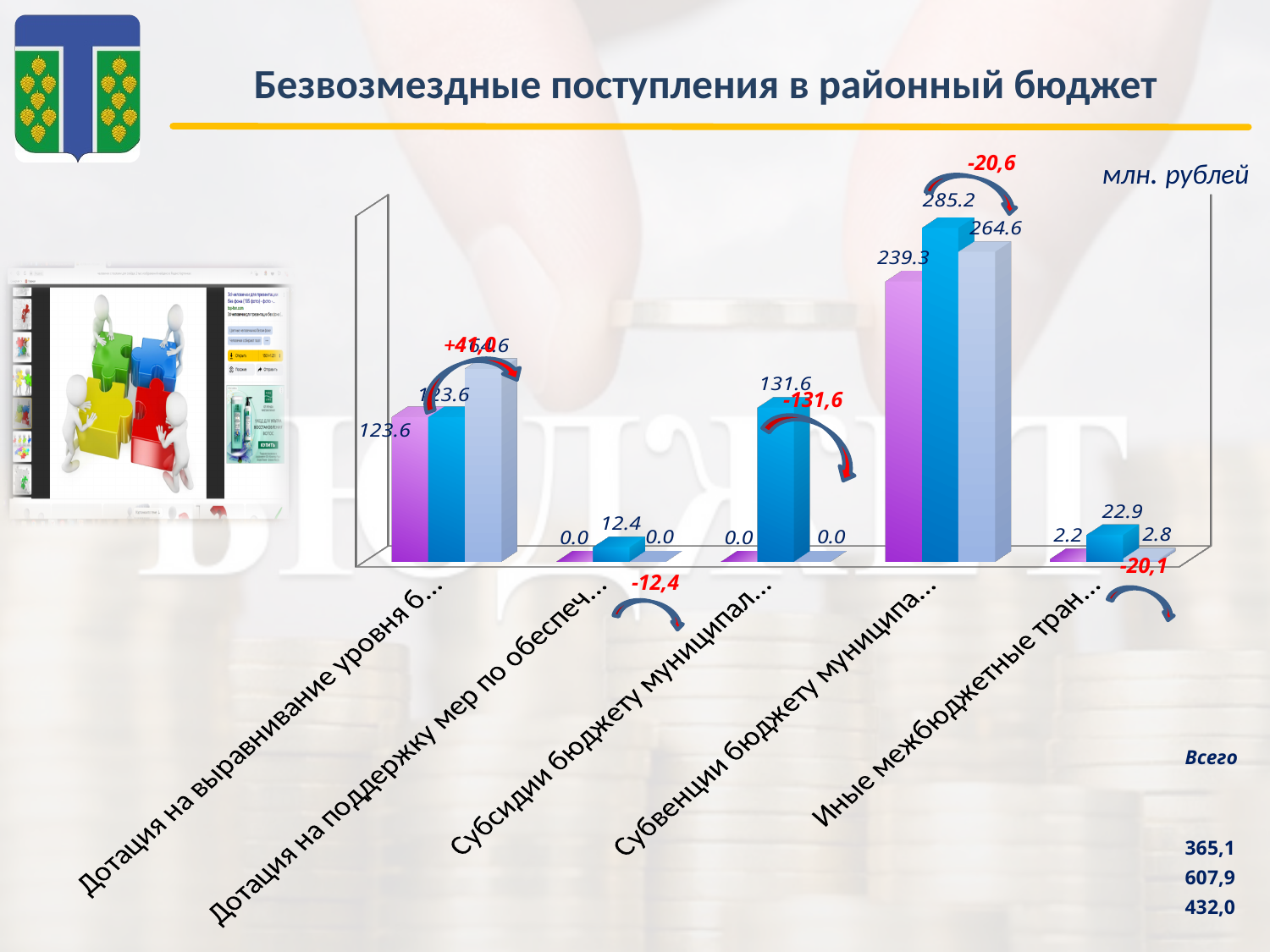
What is the value of the middle (blue) bar for the category "Субсидии бюджету муниципал..."? 131.6 What is the value of the third (light blue) bar for the category "Субвенции бюджету муниципа..."? 264.6 What is the value of the middle (blue) bar for the category "Иные межбюджетные тран..."? 22.9 Which is larger: the middle (blue) bar for "Субсидии бюджету муниципал..." or the middle (blue) bar for "Дотация на выравнивание уровня б..."? Субсидии бюджету муниципал... What is the title of the chart on the slide? Безвозмездные поступления в районный бюджет What is the value of the middle (blue) bar for the category "Субвенции бюджету муниципа..."? 285.2 What kind of chart is shown on the slide? bar chart How many categories are shown along the x axis of the chart? 5 Which category has the highest value for the middle (blue) bar? Субвенции бюджету муниципа... What is the value of the middle (blue) bar for the category "Дотация на поддержку мер по обеспеч..."? 12.4 What is the difference between the middle (blue) bar and the first (purple) bar for "Субвенции бюджету муниципа..."? 45.9 What is the value of the first (purple) bar for the category "Субвенции бюджету муниципа..."? 239.3